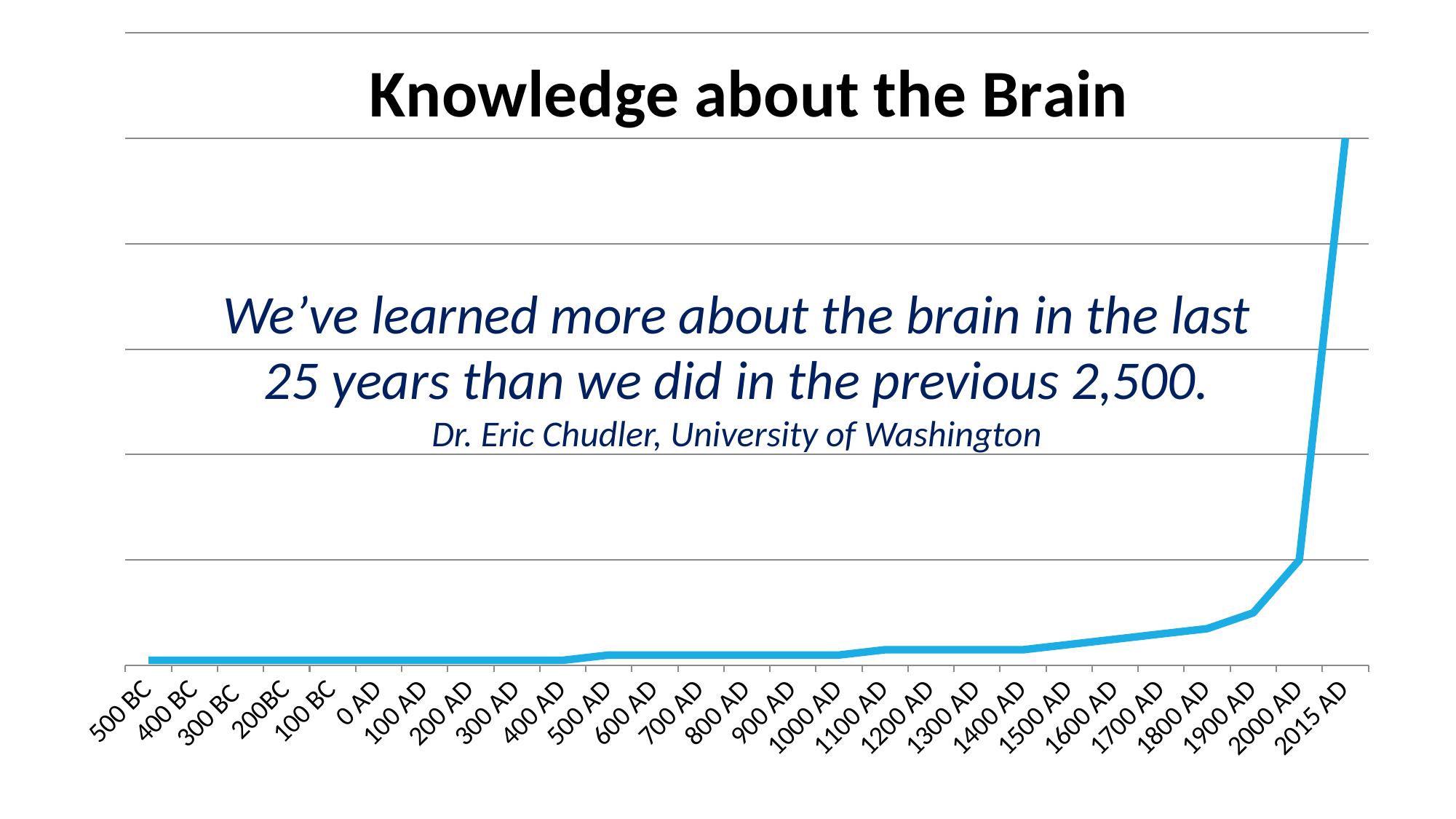
Which has the larger value, 500 BC or 1900 AD? 1900 AD What is the first category on the x axis of the chart? 500 BC Which has the larger value, 1800 AD or 2000 AD? 2000 AD Which x-axis category has the highest value on the chart? 2015 AD Do the values on the chart generally rise or fall from 500 BC to 2015 AD? rise Between which two consecutive x-axis categories does the line rise most steeply? 2000 AD and 2015 AD What kind of chart is shown on the slide? line chart Which has the larger value, 2000 AD or 2015 AD? 2015 AD How many points are plotted along the x axis of the chart? 27 What is the last category on the x axis of the chart? 2015 AD What is the title of the chart? Knowledge about the Brain